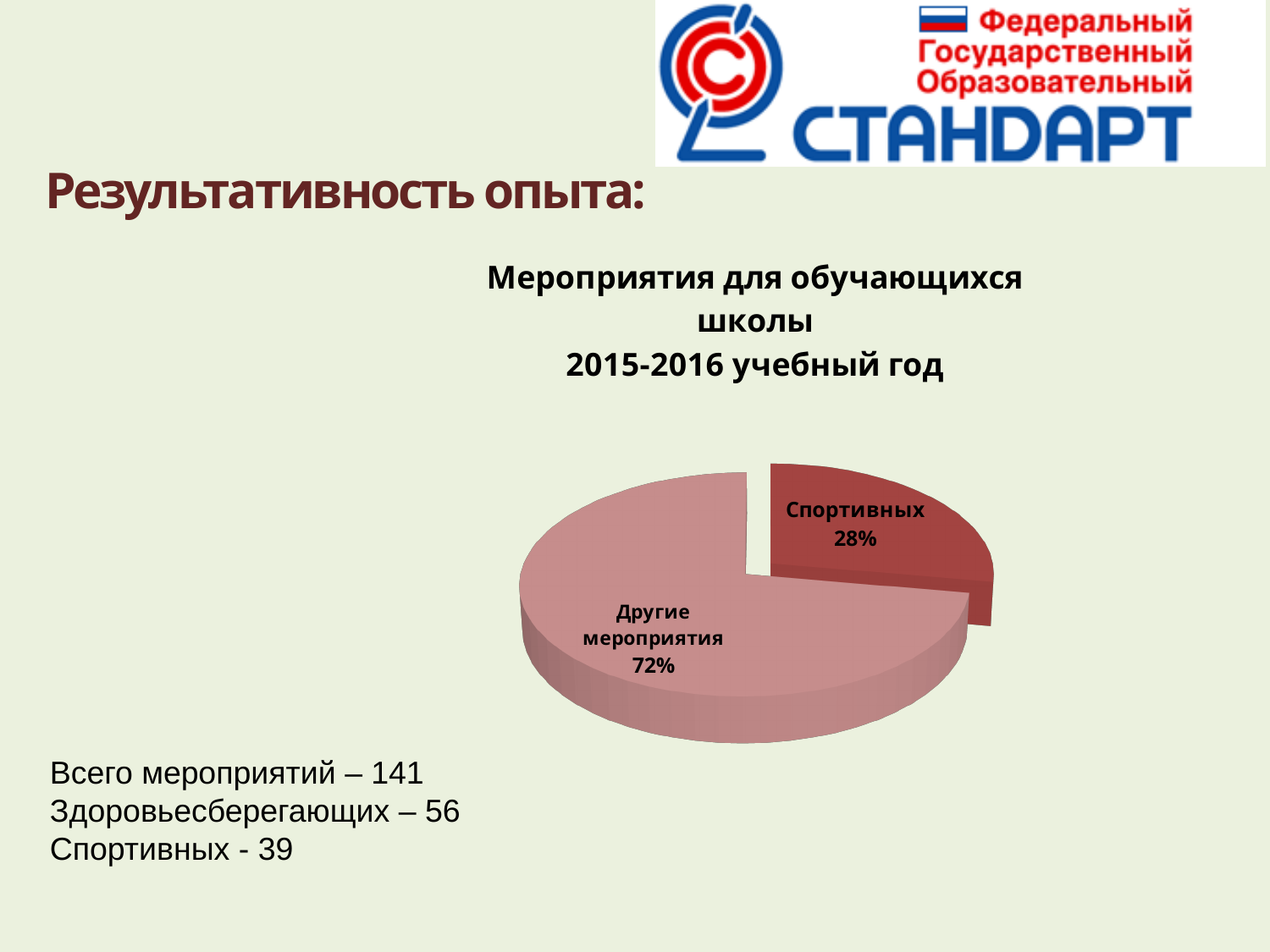
What kind of chart is shown on the slide? Pie chart What share of the pie does the "Спортивных" slice represent? 28% Which slice of the pie chart is the largest? Другие мероприятия How many slices does the pie chart have? 2 What is the title of the chart? Мероприятия для обучающихся школы 2015-2016 учебный год Is the share of the "Спортивных" slice greater or less than 50%? less Which slice is pulled out (exploded) from the pie? Спортивных What is the difference in percentage points between the "Другие мероприятия" slice and the "Спортивных" slice? 44 Which slice is larger, "Спортивных" or "Другие мероприятия"? Другие мероприятия Which slice of the pie chart is the smallest? Спортивных What share of the pie does the "Другие мероприятия" slice represent? 72%